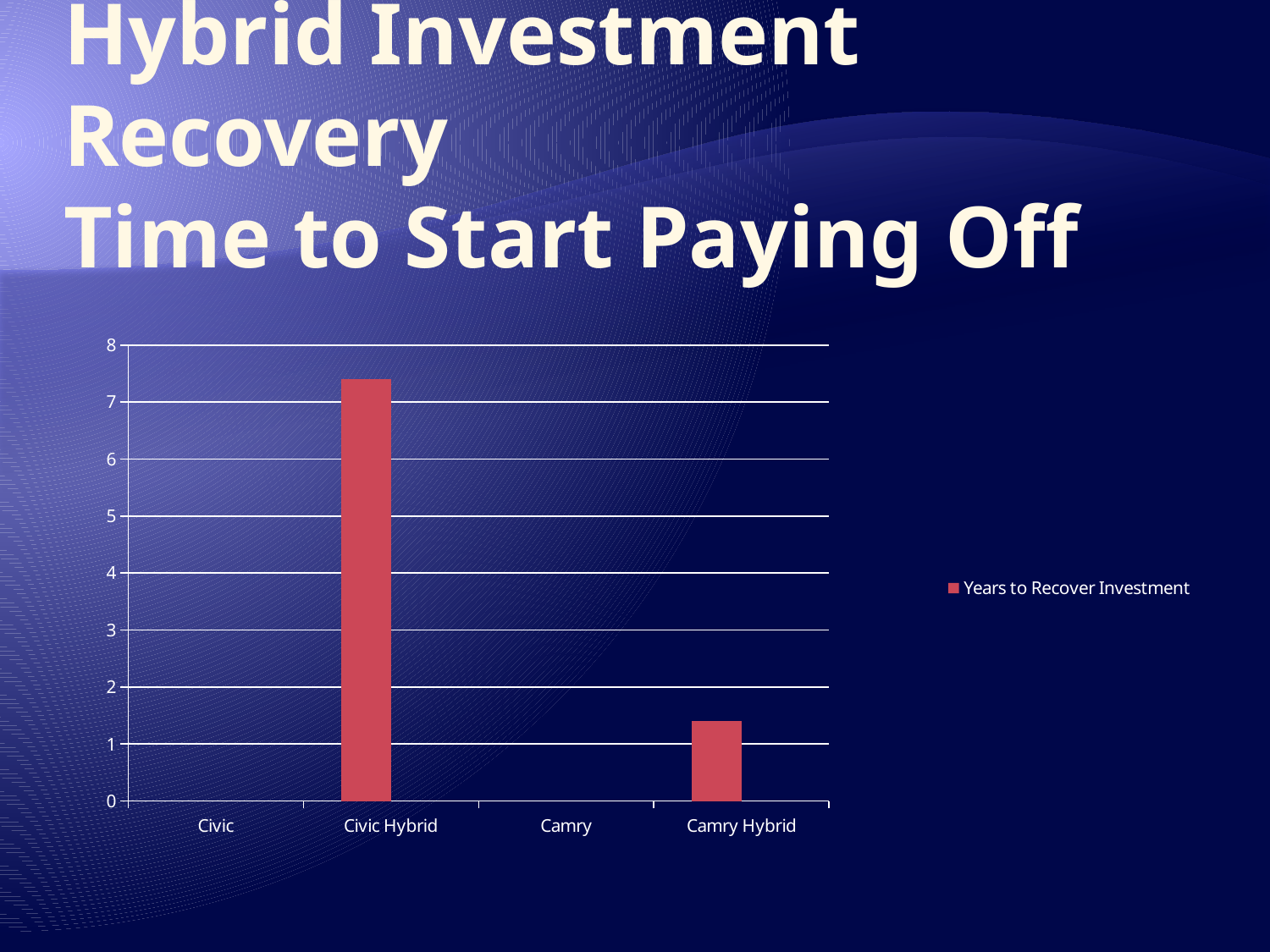
Which two categories show no visible bar in the chart? Civic and Camry What is the series name shown in the chart's legend? Years to Recover Investment How many series does the chart's legend list? 1 Is the value for Camry Hybrid greater or less than 1? greater Which has a larger value, Civic Hybrid or Camry Hybrid? Civic Hybrid What kind of chart is shown on the slide? bar chart Which category has the highest value in the chart? Civic Hybrid What is the highest value shown on the chart's y axis? 8 Is the value for Camry Hybrid greater or less than 2? less How many categories are shown on the x axis of the chart? 4 Is the value for Civic Hybrid greater or less than 7? greater